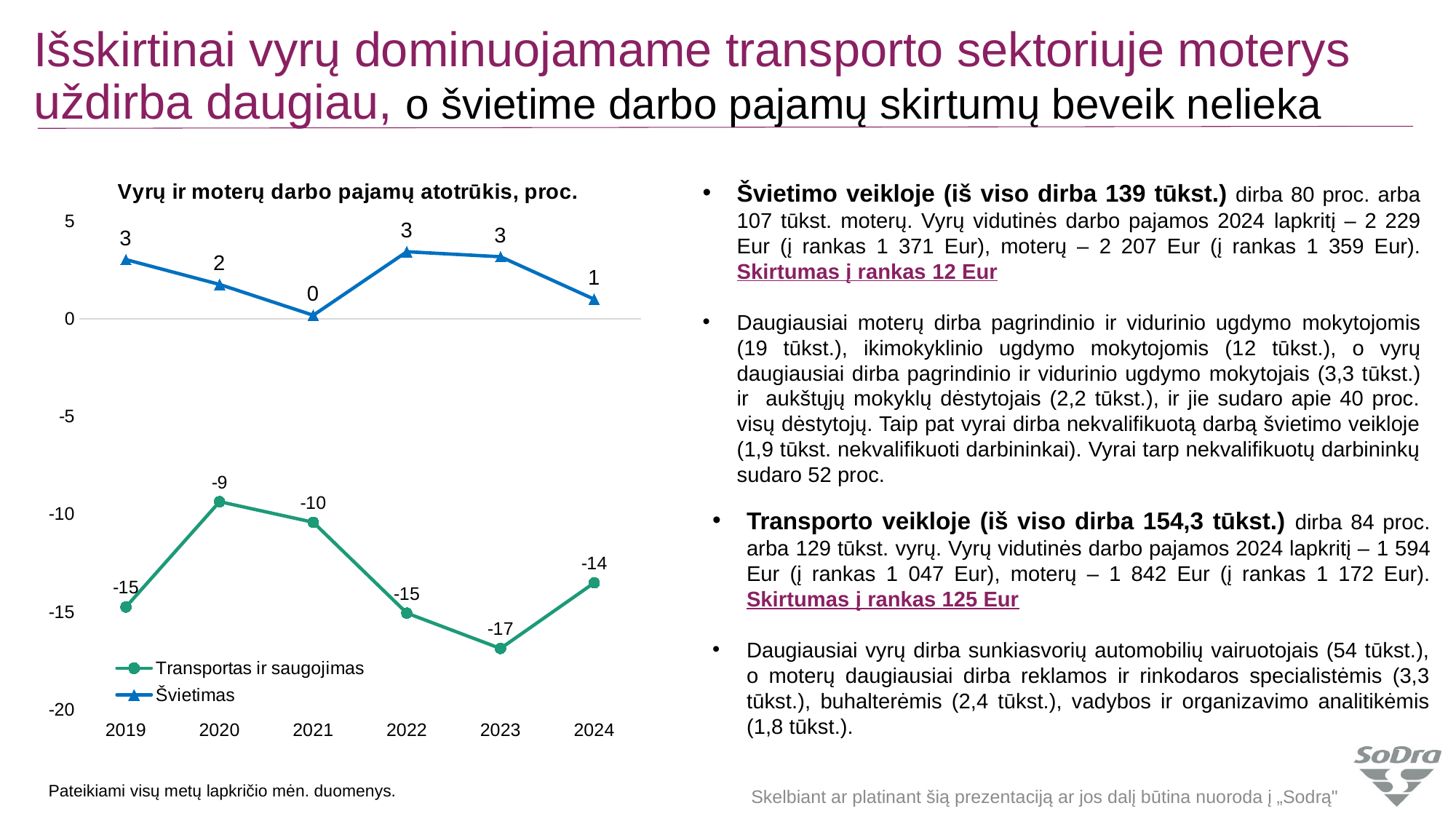
Which series has the larger value in 2019, Transportas ir saugojimas or Švietimas? Švietimas Does the Transportas ir saugojimas series rise or fall from 2023 to 2024? Rise What kind of chart is shown on the slide? Line chart What is the title of the chart? Vyrų ir moterų darbo pajamų atotrūkis, proc. How many series does the legend list? 2 What is the value for Transportas ir saugojimas in 2024? -14 How many years are shown on the x axis? 6 In which year is the Transportas ir saugojimas series at its lowest? 2023 In which year is the Transportas ir saugojimas series at its highest? 2020 What is the difference between the Švietimas and Transportas ir saugojimas values in 2024? 15 What is the value for Transportas ir saugojimas in 2023? -17 What is the value for Švietimas in 2021? 0